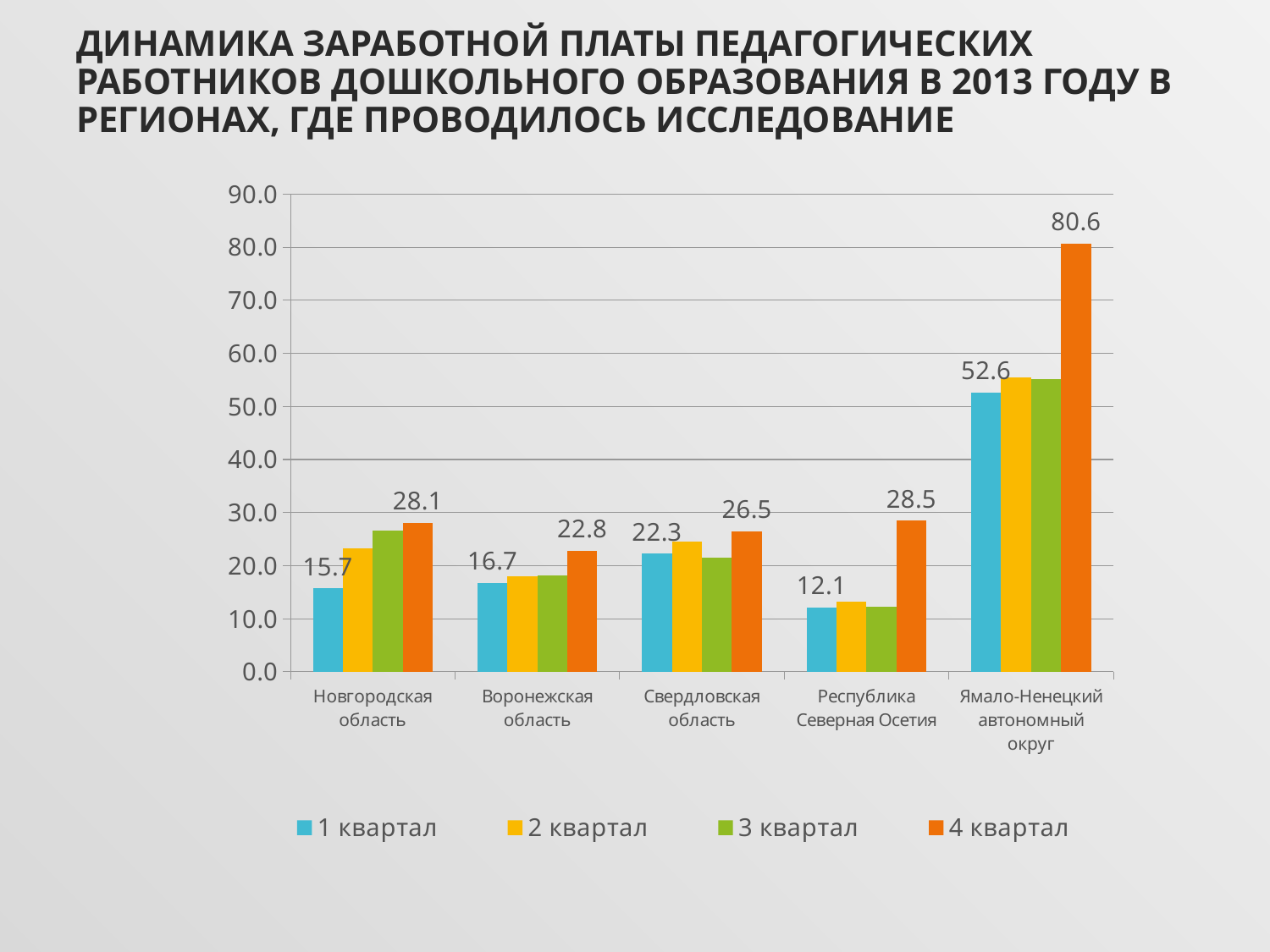
What is the value for 4 квартал in Воронежская область? 22.8 Is the value for 2 квартал in Ямало-Ненецкий автономный округ greater or less than 50.0? greater What is the value for 1 квартал in Республика Северная Осетия? 12.1 Which region has the lowest value for 1 квартал? Республика Северная Осетия What kind of chart is shown on the slide? bar chart What is the value for 4 квартал in Ямало-Ненецкий автономный округ? 80.6 How many series does the legend list? 4 What is the difference between the 4 квартал and 1 квартал values for Ямало-Ненецкий автономный округ? 28.0 What is the difference between the 4 квартал and 1 квартал values for Новгородская область? 12.4 Which region has the highest value for 4 квартал? Ямало-Ненецкий автономный округ How many regions are shown on the x axis? 5 Which is larger for 4 квартал: Новгородская область or Республика Северная Осетия? Республика Северная Осетия